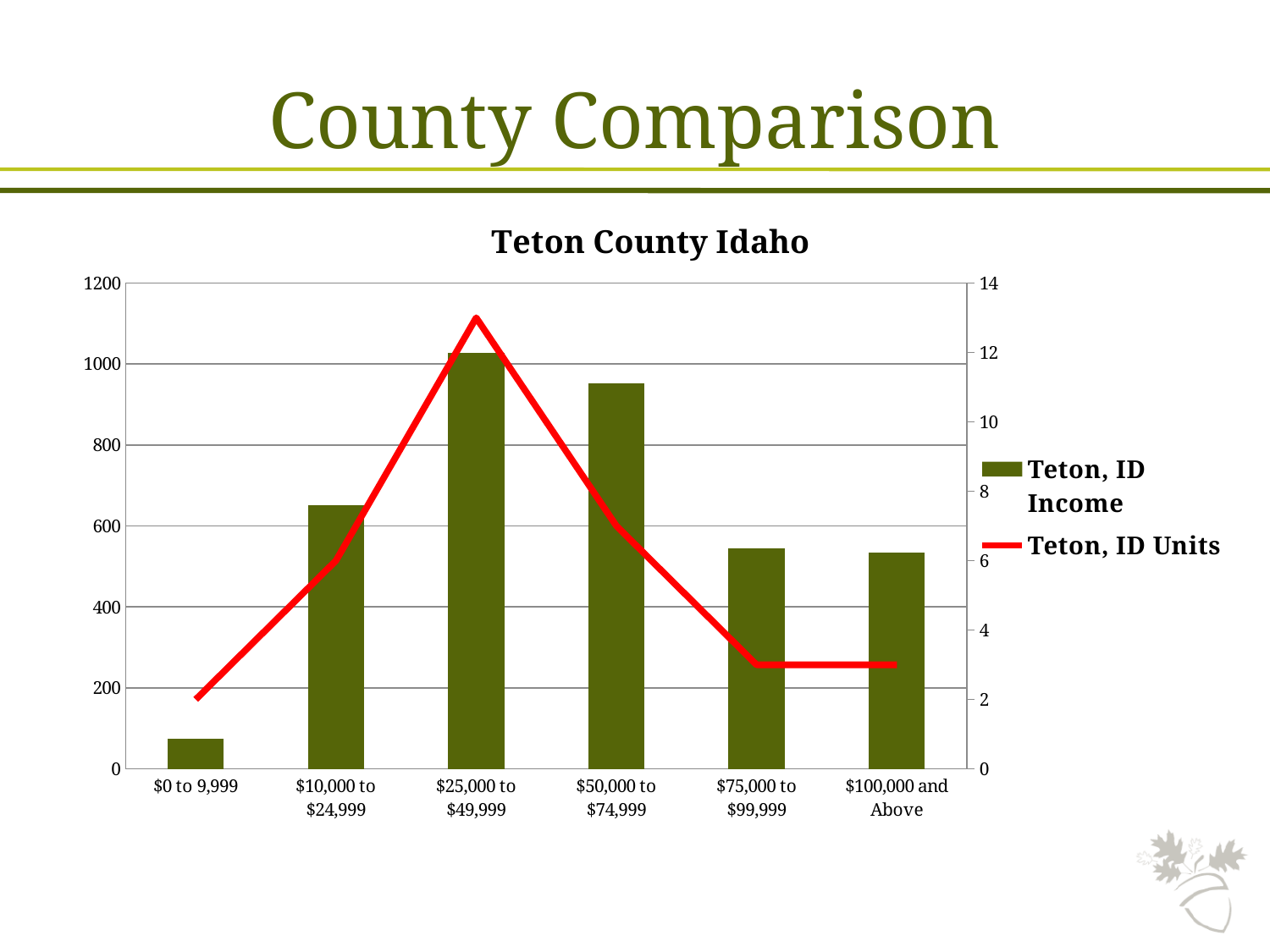
Which is larger, the Teton, ID Income value for $10,000 to $24,999 or for $75,000 to $99,999? $10,000 to $24,999 Which income category has the highest Teton, ID Income bar? $25,000 to $49,999 What is the Teton, ID Units value for $0 to 9,999? 2 Is the Teton, ID Income value for $25,000 to $49,999 greater or less than 1000? greater Is the Teton, ID Units value for $25,000 to $49,999 greater or less than 12? greater What kind of chart is this? Combination bar and line chart Which income category has the lowest Teton, ID Income bar? $0 to 9,999 What is the title of the chart? Teton County Idaho Is the Teton, ID Income value for $50,000 to $74,999 greater or less than 1000? less How many income categories are shown on the x axis? 6 How many series does the legend list? 2